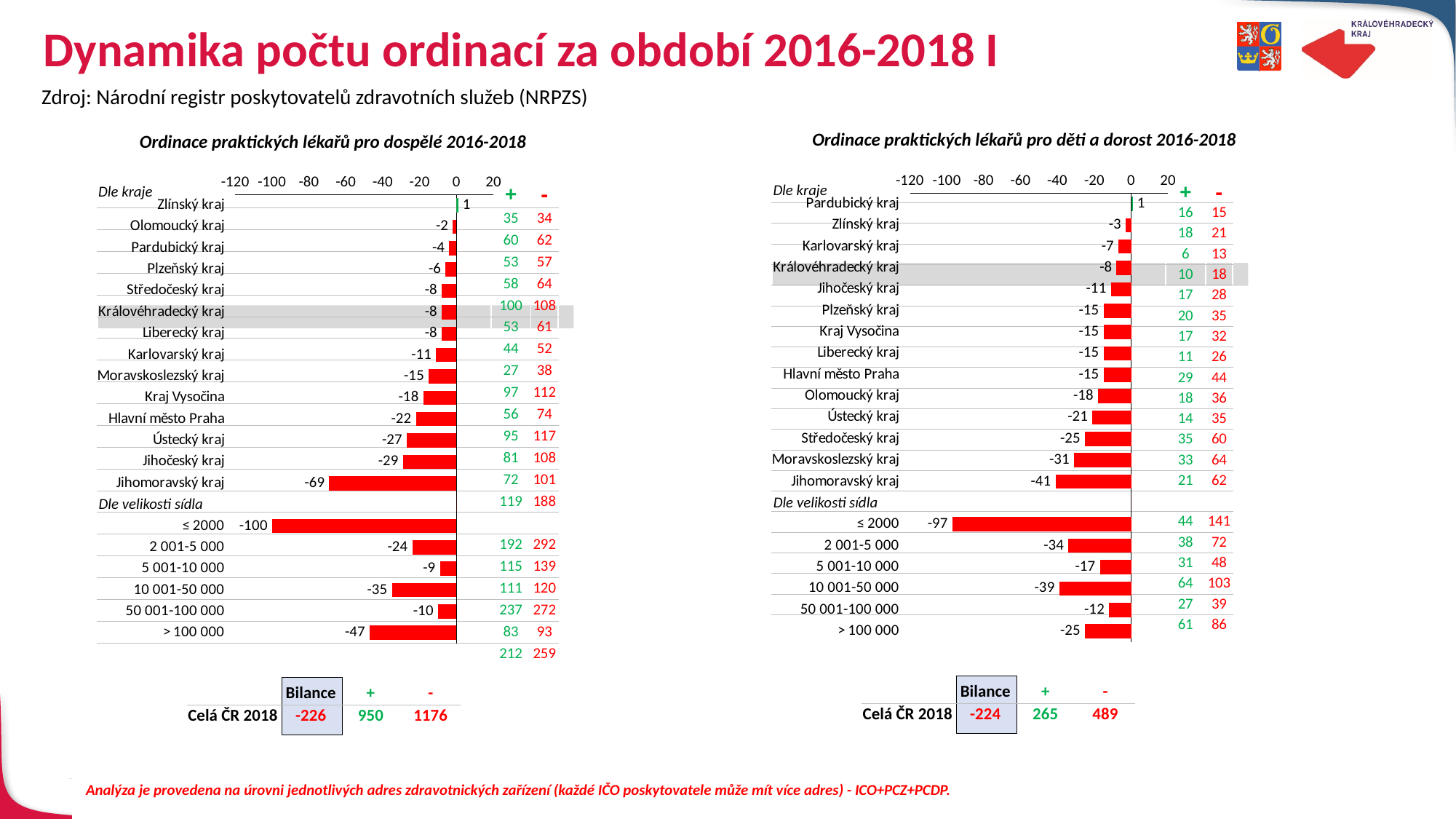
In the chart 'Ordinace praktických lékařů pro dospělé 2016-2018', what is the value for Hlavní město Praha? -22 In the chart 'Ordinace praktických lékařů pro děti a dorost 2016-2018', which is larger, the value for Středočeský kraj or the value for Moravskoslezský kraj? Středočeský kraj In the chart 'Ordinace praktických lékařů pro děti a dorost 2016-2018', what is the value for Královéhradecký kraj? -8 In the chart 'Ordinace praktických lékařů pro dospělé 2016-2018', which region (kraj) has the lowest value? Jihomoravský kraj In the chart 'Ordinace praktických lékařů pro dospělé 2016-2018', what is the value for Jihomoravský kraj? -69 In the chart 'Ordinace praktických lékařů pro děti a dorost 2016-2018', what is the value for Jihomoravský kraj? -41 In the chart 'Ordinace praktických lékařů pro dospělé 2016-2018', what is the value for the settlement size category '≤ 2000'? -100 What type of chart is 'Ordinace praktických lékařů pro dospělé 2016-2018'? Bar chart In the chart 'Ordinace praktických lékařů pro dospělé 2016-2018', which region (kraj) has the highest value? Zlínský kraj In the chart 'Ordinace praktických lékařů pro děti a dorost 2016-2018', which region (kraj) has the highest value? Pardubický kraj In the chart 'Ordinace praktických lékařů pro dospělé 2016-2018', what is the difference between the values for Ústecký kraj and Jihočeský kraj? 2 In the chart 'Ordinace praktických lékařů pro děti a dorost 2016-2018', what is the difference between the values for the settlement size categories '≤ 2000' and '2 001-5 000'? 63